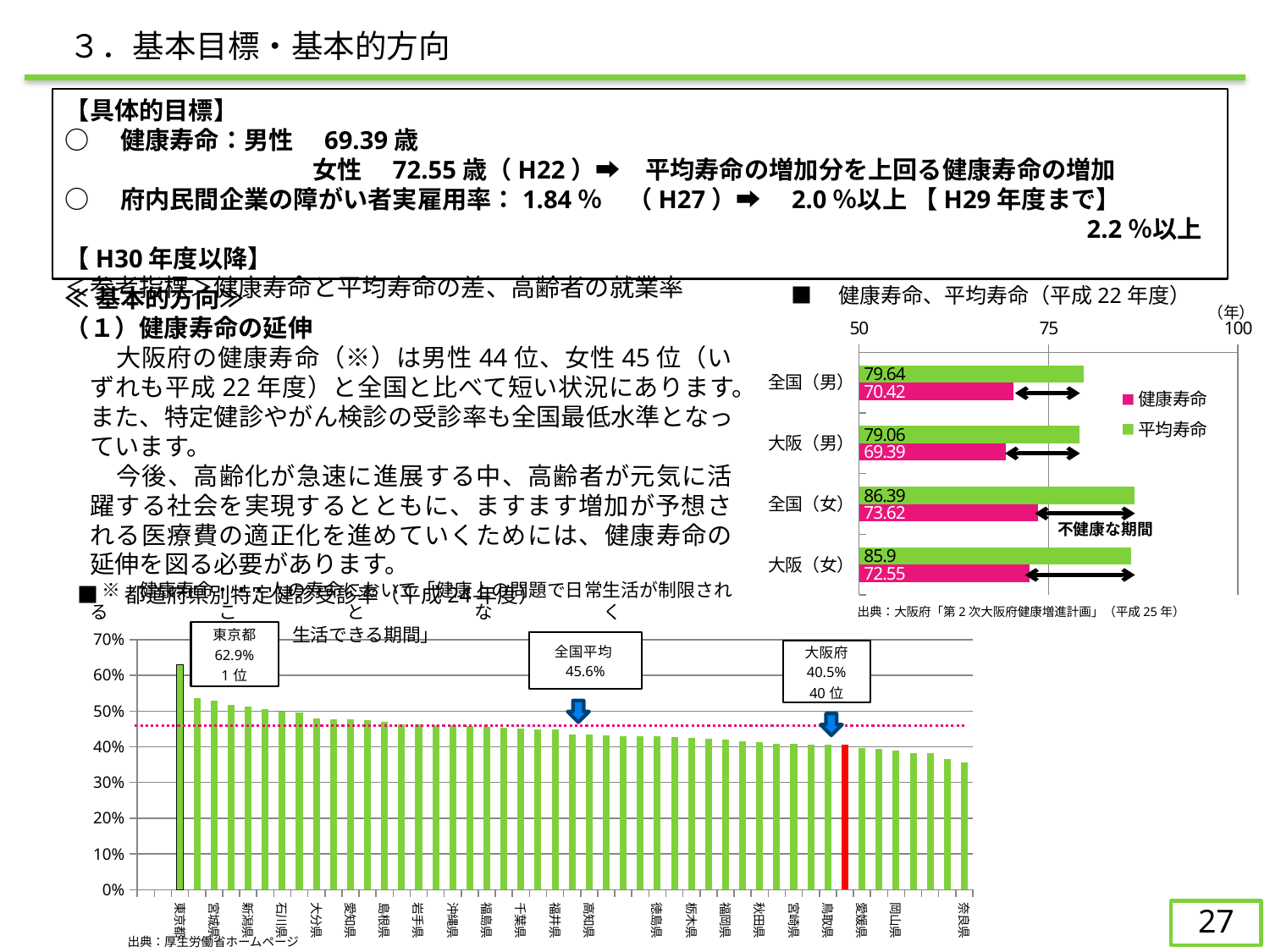
In the chart titled 健康寿命、平均寿命（平成22年度）, what is the 健康寿命 value for 大阪（男）? 69.39 In the bottom chart 都道府県別特定健診受診率（平成24年度）, what is the value for 大阪府? 40.5% In the bottom chart 都道府県別特定健診受診率（平成24年度）, what is the value for 東京都? 62.9% In the bottom chart 都道府県別特定健診受診率（平成24年度）, do the values rise or fall from left to right along the x axis? Fall In the chart titled 健康寿命、平均寿命（平成22年度）, which category has the highest 平均寿命? 全国（女） In the chart titled 健康寿命、平均寿命（平成22年度）, how many series does the legend list? 2 In the chart titled 健康寿命、平均寿命（平成22年度）, what colour represents 健康寿命? Pink In the bottom chart 都道府県別特定健診受診率（平成24年度）, what is the difference between the values for 東京都 and 大阪府? 22.4% What kind of chart is the 都道府県別特定健診受診率（平成24年度） chart at the bottom of the slide? Bar chart In the chart titled 健康寿命、平均寿命（平成22年度）, which has the larger 健康寿命, 大阪（女） or 全国（女）? 全国（女） In the chart titled 健康寿命、平均寿命（平成22年度）, what is the 平均寿命 value for 全国（女）? 86.39 In the chart titled 健康寿命、平均寿命（平成22年度）, what is the difference between 平均寿命 and 健康寿命 for 全国（男）? 9.22